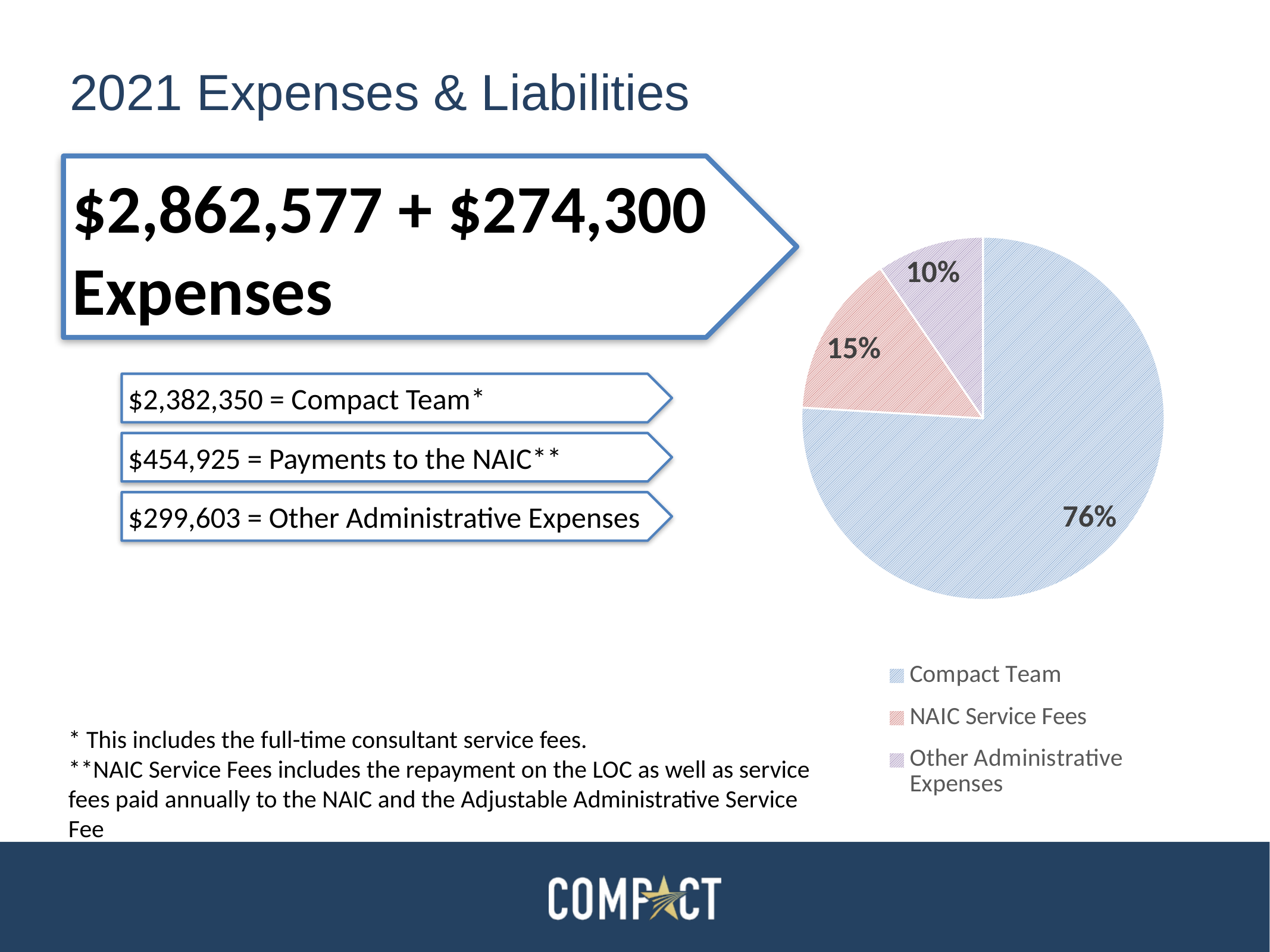
Which slice of the pie chart is the largest? Compact Team What share of the pie does Compact Team represent? 76% How many slices does the pie chart have? 3 Which slice of the pie chart is the smallest? Other Administrative Expenses Which legend entry is shown with a red pattern fill? NAIC Service Fees How many entries does the legend list? 3 Which is larger, the NAIC Service Fees slice or the Other Administrative Expenses slice? NAIC Service Fees What kind of chart is shown on the slide? pie chart What share of the pie does NAIC Service Fees represent? 15% What is the difference in percentage points between the NAIC Service Fees slice and the Other Administrative Expenses slice? 5 What is the difference in percentage points between the Compact Team slice and the NAIC Service Fees slice? 61 What share of the pie does Other Administrative Expenses represent? 10%